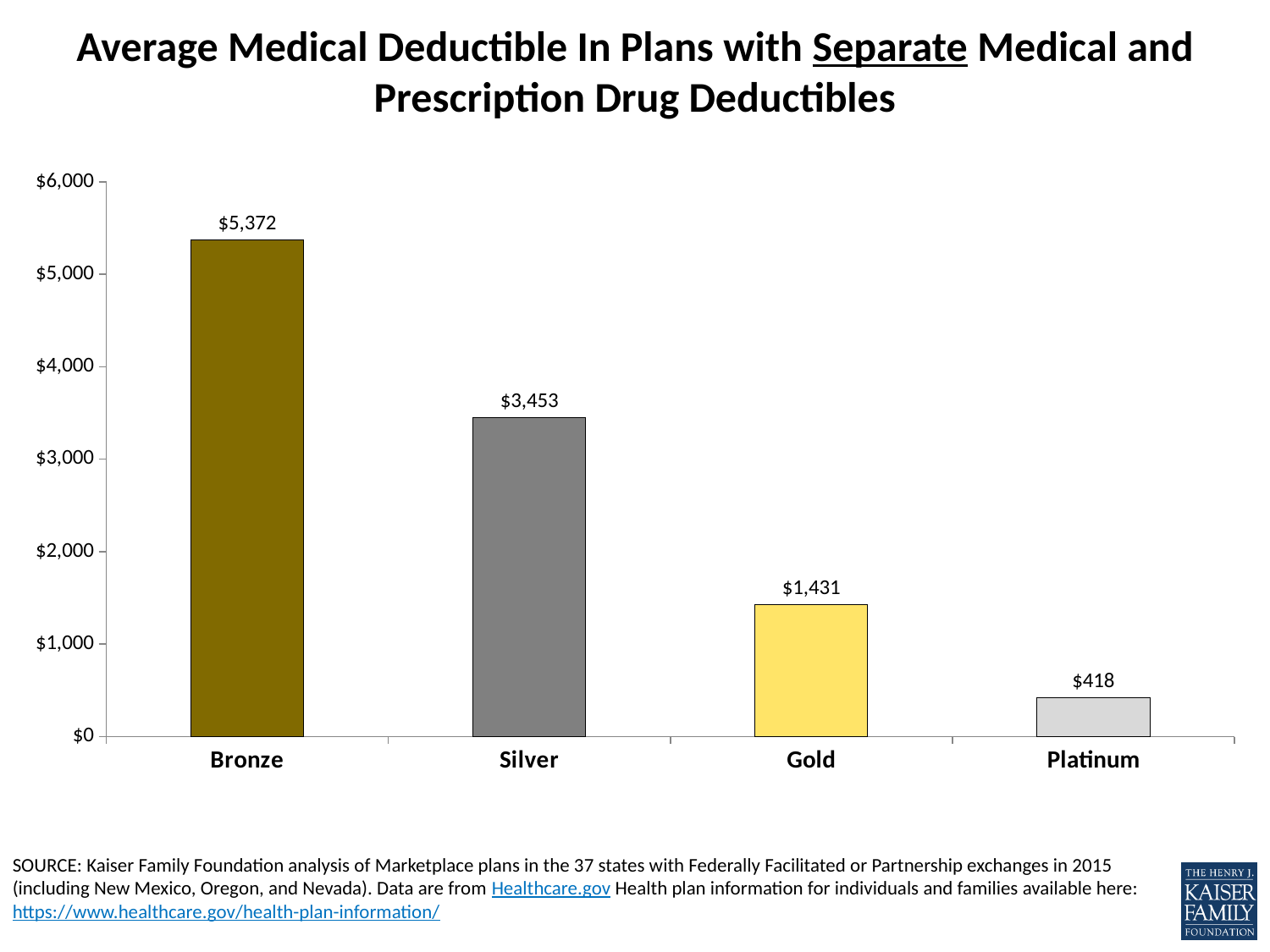
Which plan tier has the lowest average medical deductible? Platinum Is the value for Silver greater or less than $3,000? greater How many plan tiers are shown on the chart? 4 Which plan tier has the highest average medical deductible? Bronze What is the average medical deductible for Silver plans? $3,453 What is the average medical deductible for Platinum plans? $418 Which has a larger average medical deductible, Silver or Gold? Silver What kind of chart is shown on the slide? Bar chart What is the difference between the Gold and Platinum average medical deductibles? $1,013 What is the average medical deductible for Bronze plans? $5,372 What is the difference between the Bronze and Silver average medical deductibles? $1,919 What is the average medical deductible for Gold plans? $1,431